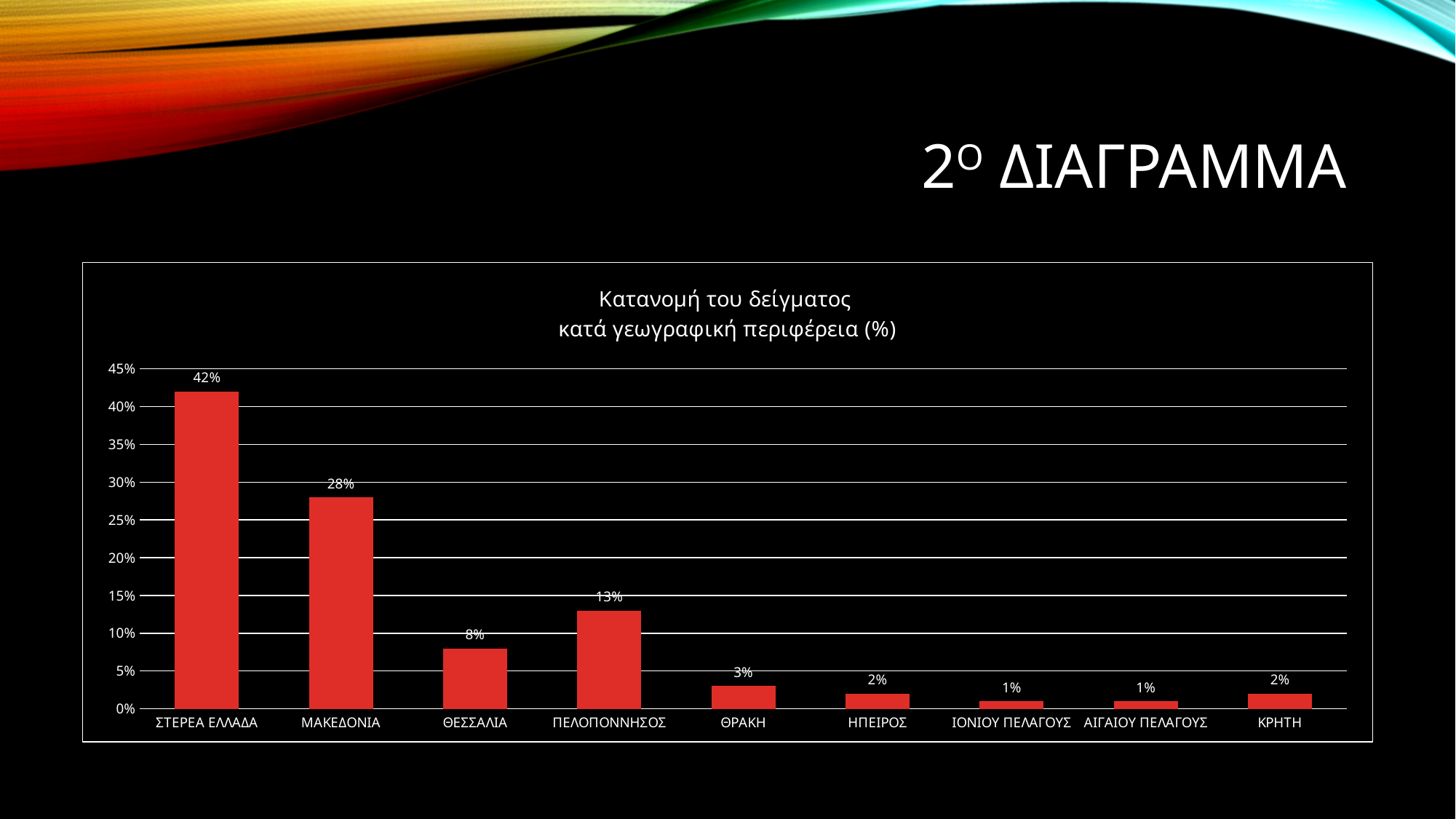
What is the value for ΠΕΛΟΠΟΝΝΗΣΟΣ? 13% Which is larger, the value for ΘΕΣΣΑΛΙΑ or the value for ΠΕΛΟΠΟΝΝΗΣΟΣ? ΠΕΛΟΠΟΝΝΗΣΟΣ Which region has the highest value? ΣΤΕΡΕΑ ΕΛΛΑΔΑ Is the value for ΜΑΚΕΔΟΝΙΑ greater or less than 25%? greater What is the difference between the values for ΠΕΛΟΠΟΝΝΗΣΟΣ and ΘΕΣΣΑΛΙΑ? 5% What is the value for ΘΡΑΚΗ? 3% How many regions are shown on the x axis? 9 What is the value for ΜΑΚΕΔΟΝΙΑ? 28% What kind of chart is shown on the slide? bar chart What is the difference between the values for ΣΤΕΡΕΑ ΕΛΛΑΔΑ and ΜΑΚΕΔΟΝΙΑ? 14% What is the value for ΣΤΕΡΕΑ ΕΛΛΑΔΑ? 42% What is the title of the chart? Κατανομή του δείγματος κατά γεωγραφική περιφέρεια (%)